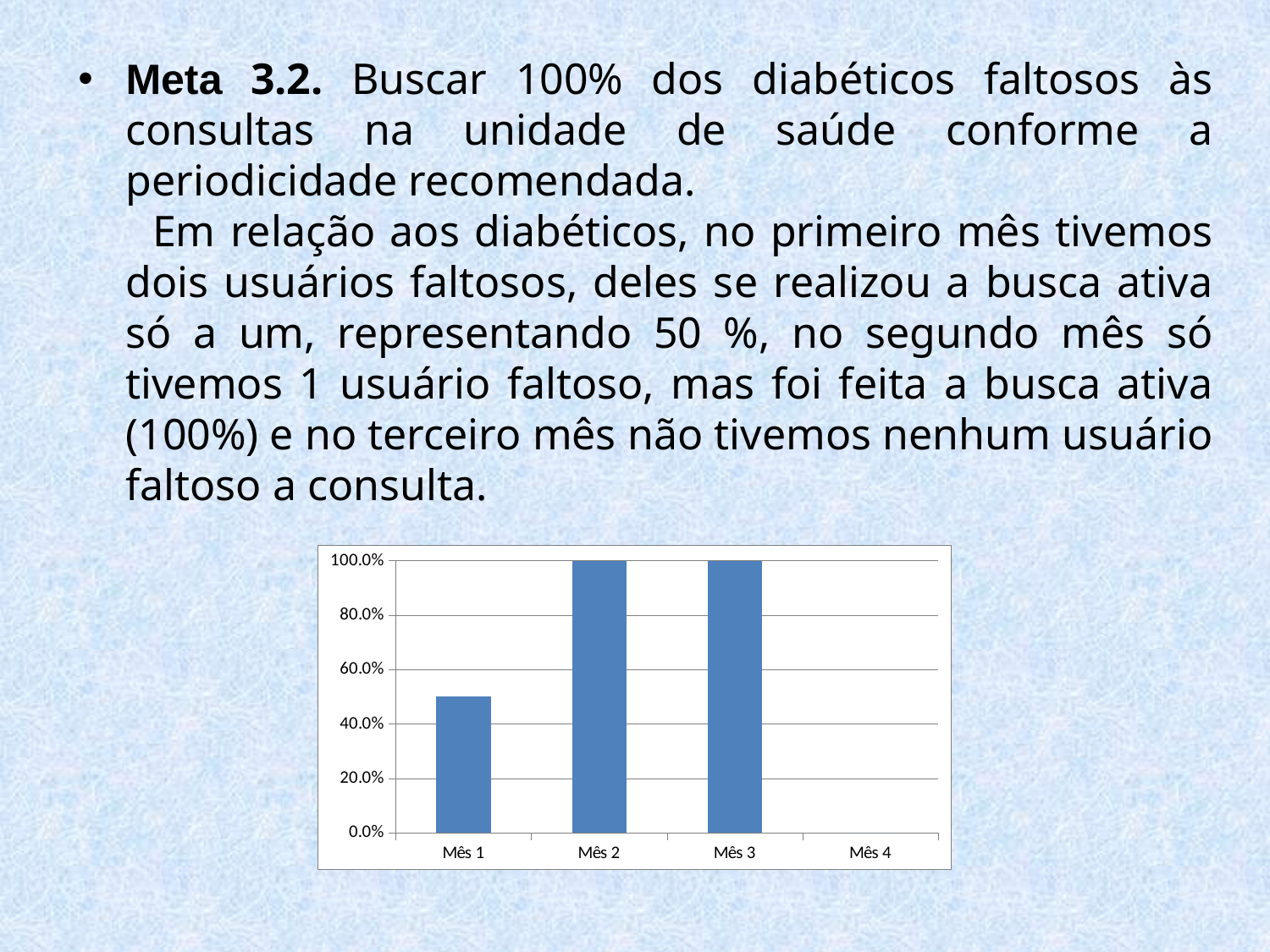
Does the value rise or fall from Mês 1 to Mês 2? rise What is the value for Mês 2 in the chart? 100.0% Is the value for Mês 1 greater or less than 40.0%? greater What is the difference between the values for Mês 2 and Mês 3? 0.0% How many month categories are shown on the x axis of the chart? 4 Is the value for Mês 1 greater or less than 60.0%? less Which is larger, the value for Mês 1 or the value for Mês 2? Mês 2 What kind of chart is shown on the slide? bar chart What is the highest tick value shown on the y axis of the chart? 100.0% What colour are the bars in the chart? blue What is the value for Mês 3 in the chart? 100.0% Among the months with a visible bar, which has the lowest value? Mês 1